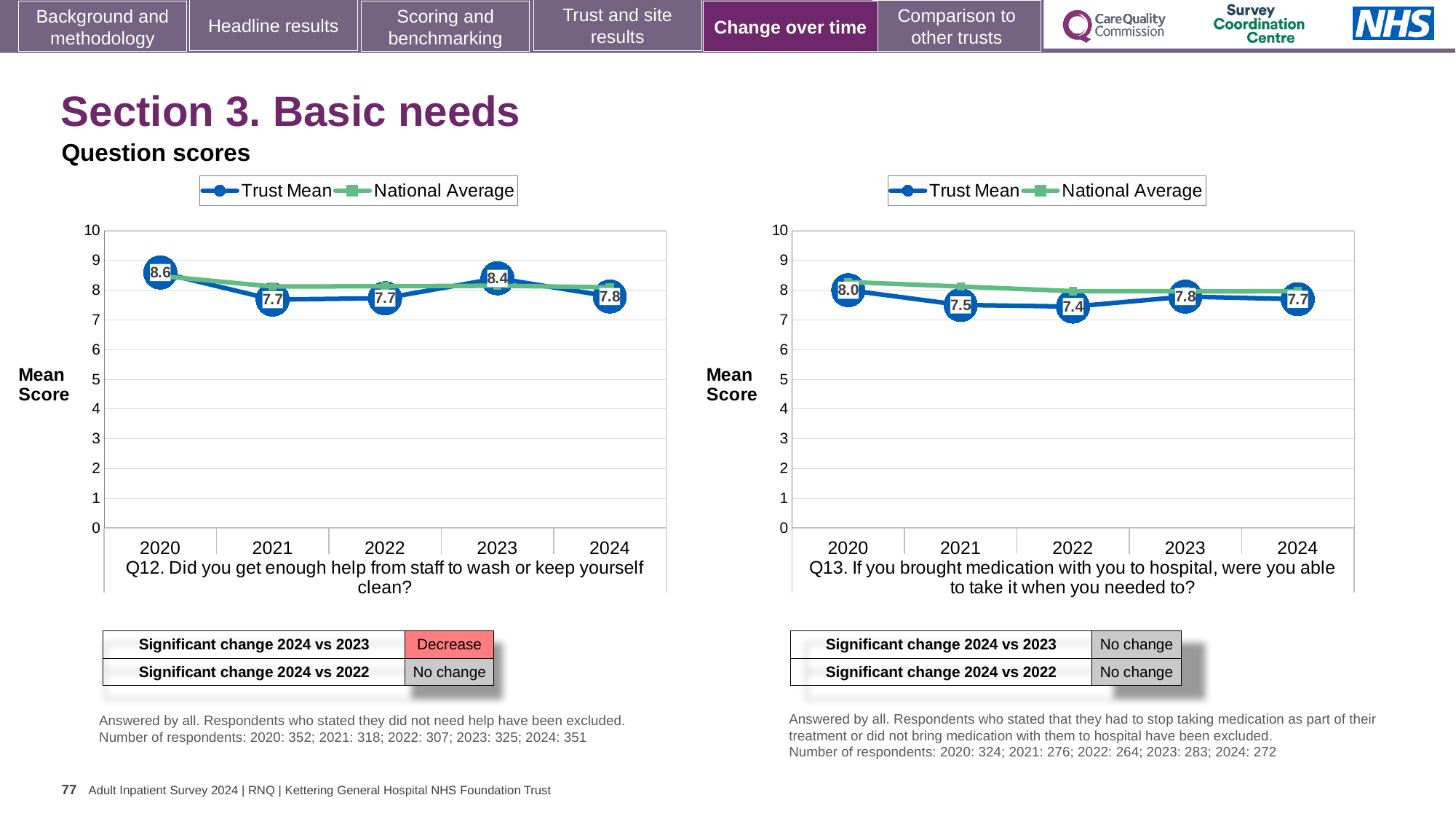
In the Q12 chart (left), what is the Trust Mean for 2023? 8.4 In the Q12 chart (left), what is the Trust Mean for 2020? 8.6 In the Q12 chart (left), what is the difference between the Trust Mean in 2020 and in 2024? 0.8 In the Q13 chart (right), is the National Average for 2020 greater or less than 7? greater In the Q13 chart (right), is the Trust Mean for 2020 larger or smaller than the Trust Mean for 2021? larger What kind of chart is the Q13 chart (right)? line chart In the Q13 chart (right), what is the Trust Mean for 2022? 7.4 In the Q12 chart (left), how many years are plotted on the x axis? 5 How many series does the legend of the Q12 chart (left) list? 2 In the Q13 chart (right), which year has the lowest Trust Mean? 2022 In the Q13 chart (right), what is the Trust Mean for 2024? 7.7 In the Q12 chart (left), which year has the highest Trust Mean? 2020